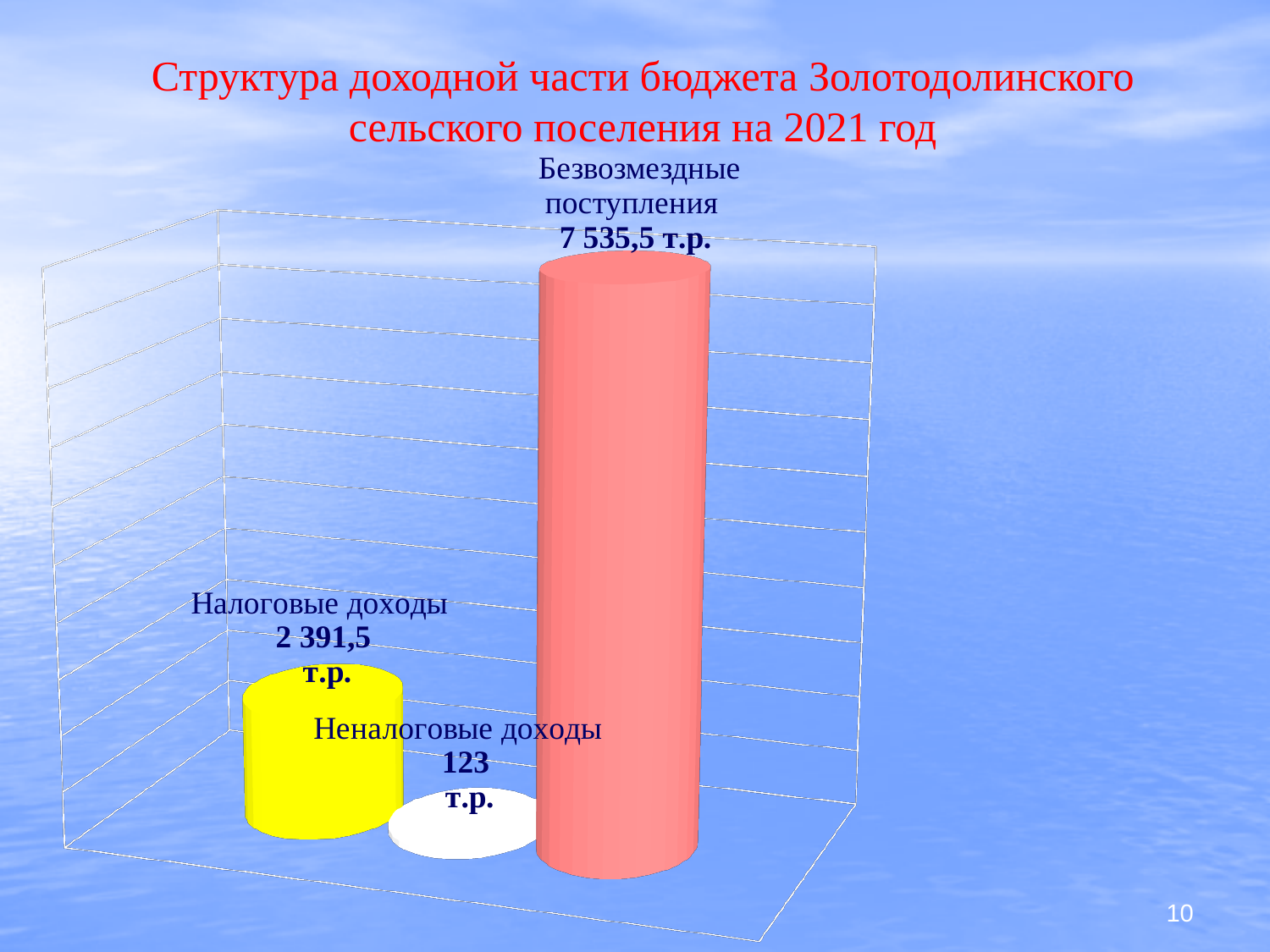
What kind of chart is shown on the slide? Bar chart What is the value shown for Безвозмездные поступления? 7 535,5 т.р. What colour is the bar for Налоговые доходы? Yellow What is the value shown for Налоговые доходы? 2 391,5 т.р. What is the difference between Безвозмездные поступления and Налоговые доходы? 5 144 т.р. What is the value shown for Неналоговые доходы? 123 т.р. Which category has the highest value? Безвозмездные поступления Which is larger, Налоговые доходы or Неналоговые доходы? Налоговые доходы Which category has the lowest value? Неналоговые доходы What is the total of the three values shown in the chart? 10 050 т.р. How many categories are shown in the chart? 3 What is the difference between Налоговые доходы and Неналоговые доходы? 2 268,5 т.р.